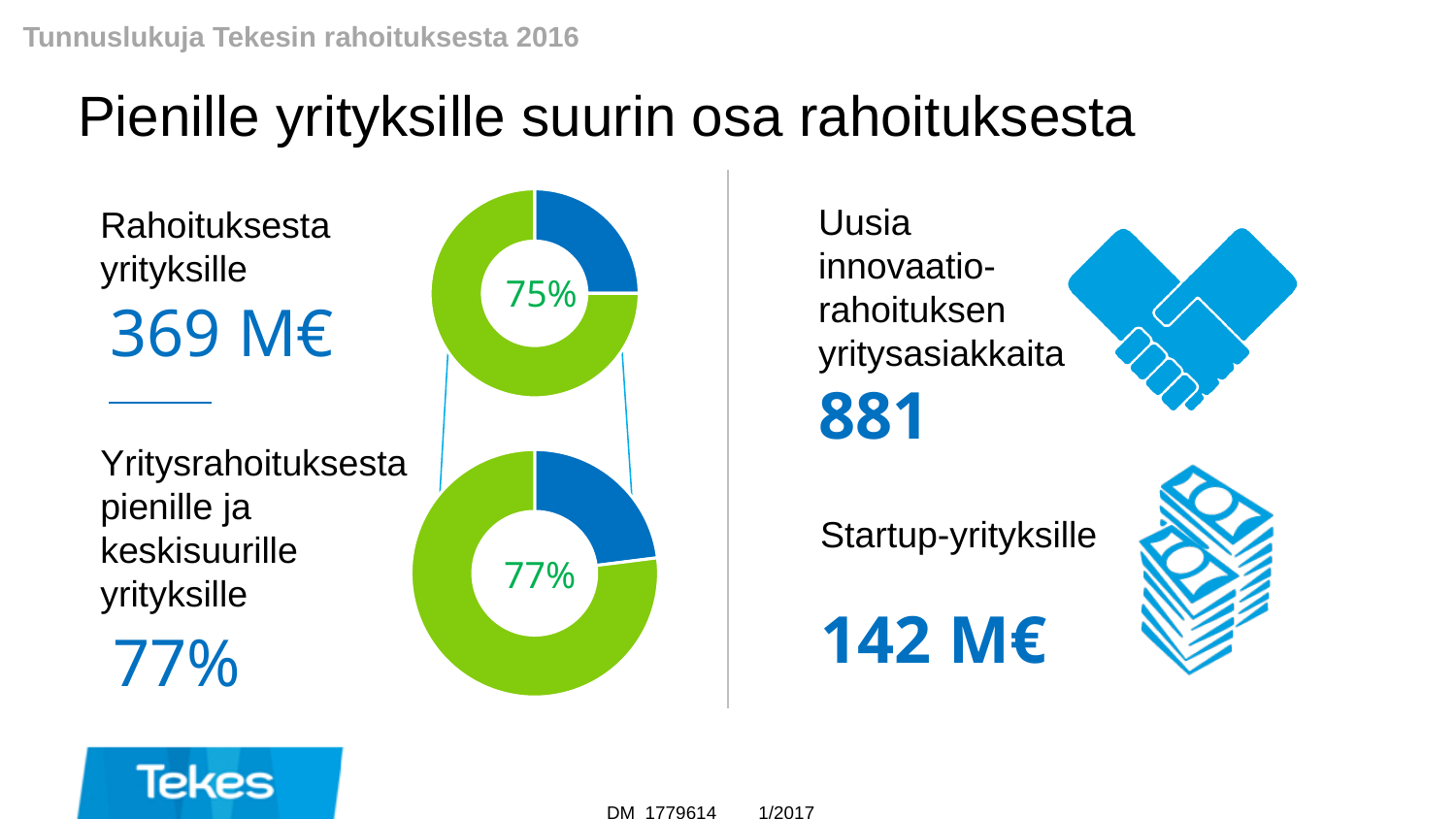
Is the green slice of the upper donut chart greater or less than 50% of the chart? greater How many slices does the lower donut chart have? 2 How many slices does the upper donut chart have? 2 What kind of chart is the lower chart on the left side of the slide? Pie (donut) chart What share of the lower donut chart does the green slice represent? 77% In the lower donut chart, which slice is larger, the green one or the blue one? Green What share of the upper donut chart does the green slice represent? 75% What percentage is printed in the centre of the lower donut chart? 77% What kind of chart is the upper chart on the left side of the slide? Pie (donut) chart What colour is the smaller slice in both donut charts? Blue What percentage is printed in the centre of the upper donut chart? 75% In the upper donut chart, which slice is larger, the green one or the blue one? Green